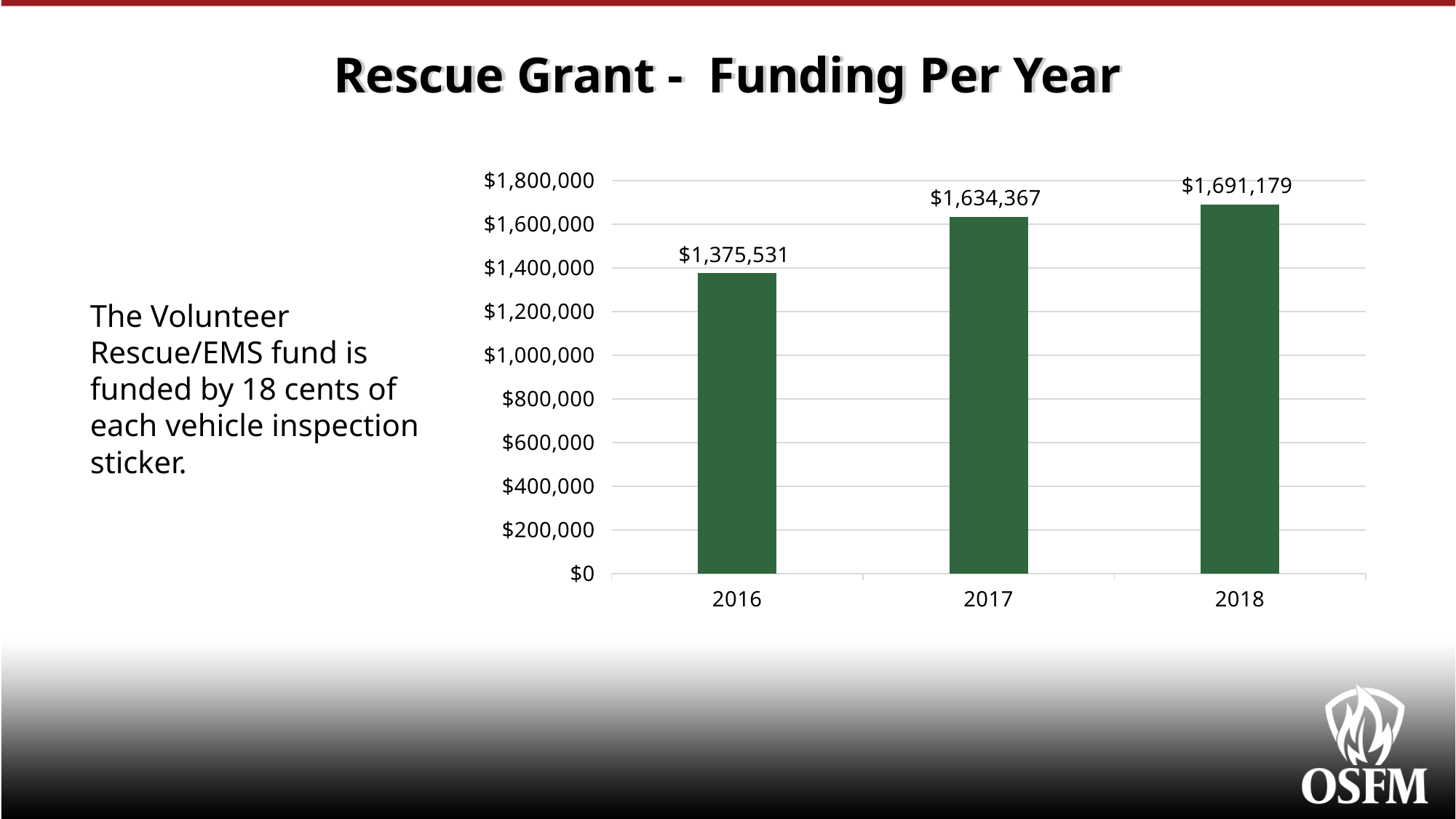
How much more funding was there in 2017 than in 2016? $258,836 Which year had more funding, 2016 or 2017? 2017 What was the Rescue Grant funding in 2018? $1,691,179 What was the Rescue Grant funding in 2017? $1,634,367 Which year had the lowest Rescue Grant funding? 2016 Does the funding rise or fall from 2016 to 2018? Rises How many years are shown in the chart? 3 What is the difference in funding between 2018 and 2017? $56,812 Is the funding for 2016 greater or less than $1,400,000? less What type of chart is shown on the slide? Bar chart What was the Rescue Grant funding in 2016? $1,375,531 Which year had the highest Rescue Grant funding? 2018